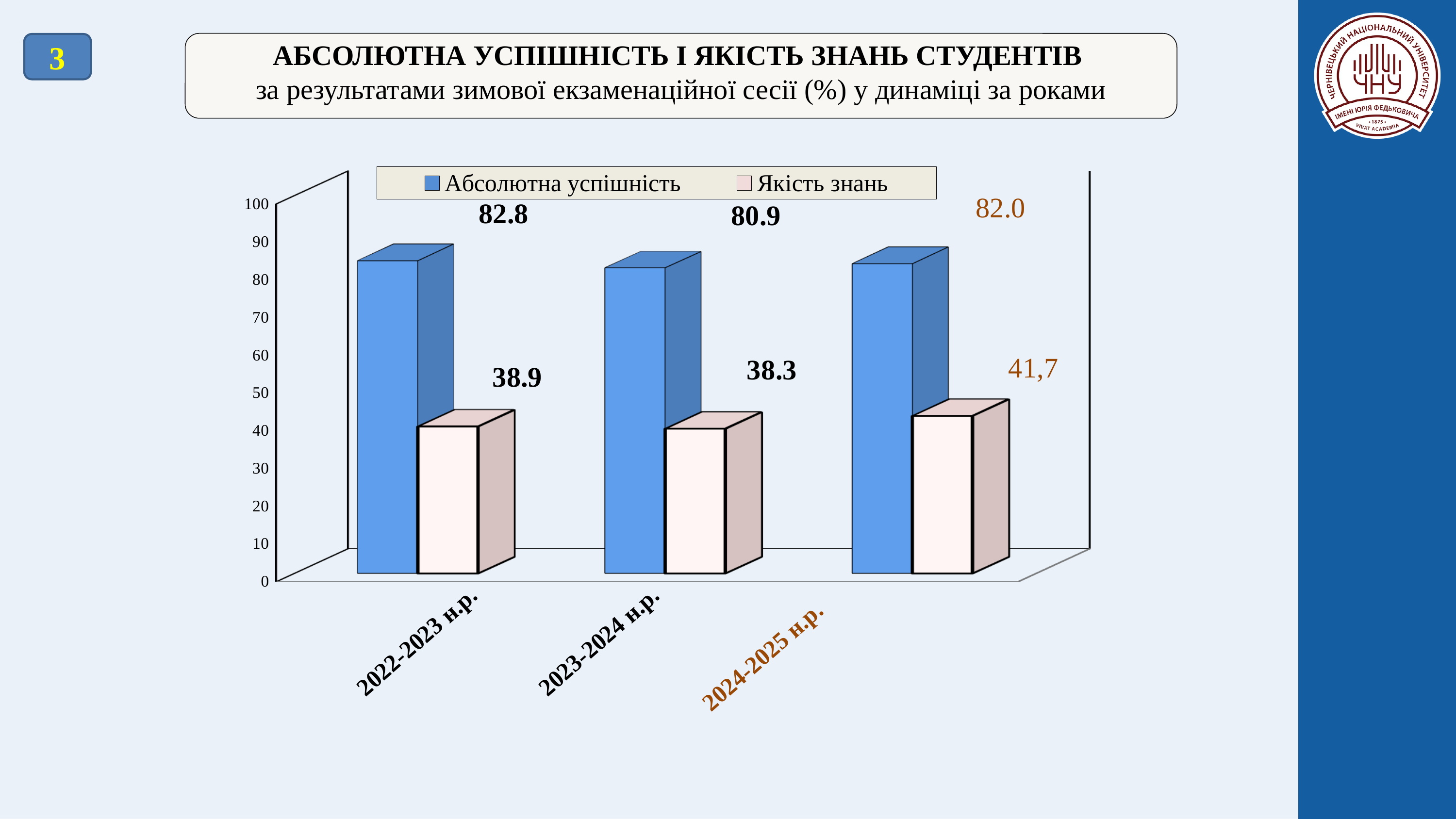
In which academic year is Абсолютна успішність the lowest? 2023-2024 н.р. What is the value of Абсолютна успішність for 2022-2023 н.р.? 82.8 What kind of chart is shown on the slide? Bar chart Which is larger: Якість знань in 2022-2023 н.р. or in 2023-2024 н.р.? 2022-2023 н.р. What is the value of Якість знань for 2024-2025 н.р.? 41,7 What is the value of Абсолютна успішність for 2024-2025 н.р.? 82.0 In which academic year is Якість знань the highest? 2024-2025 н.р. Which series is shown in blue in the legend? Абсолютна успішність How many academic years are shown on the x axis? 3 What is the difference between Абсолютна успішність in 2022-2023 н.р. and 2023-2024 н.р.? 1.9 What is the value of Якість знань for 2023-2024 н.р.? 38.3 How many series does the legend list? 2